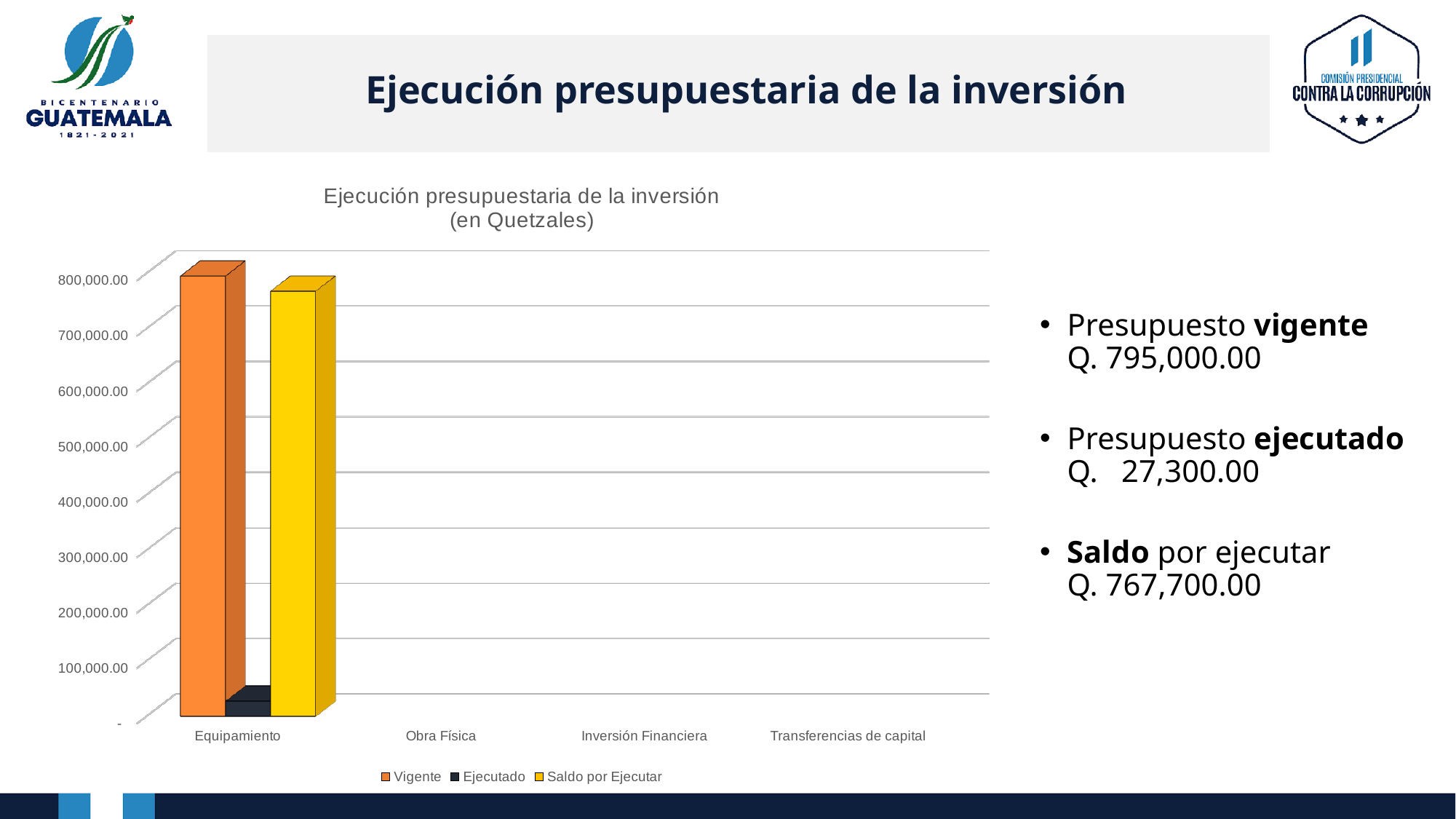
Is the Saldo por Ejecutar value for Equipamiento greater or less than 600,000.00? greater For Equipamiento, which is larger: the Vigente bar or the Ejecutado bar? Vigente What is the title of the chart? Ejecución presupuestaria de la inversión (en Quetzales) Which series has the tallest bar for Equipamiento? Vigente How many categories are shown on the x axis of the chart? 4 Is the Vigente value for Equipamiento greater or less than 700,000.00? greater What kind of chart is shown on the slide? bar chart Which series has the shortest bar for Equipamiento? Ejecutado Is the Ejecutado value for Equipamiento greater or less than 100,000.00? less Which colour represents the Saldo por Ejecutar series in the chart legend? yellow For Equipamiento, which is larger: the Vigente bar or the Saldo por Ejecutar bar? Vigente How many series does the chart legend list? 3